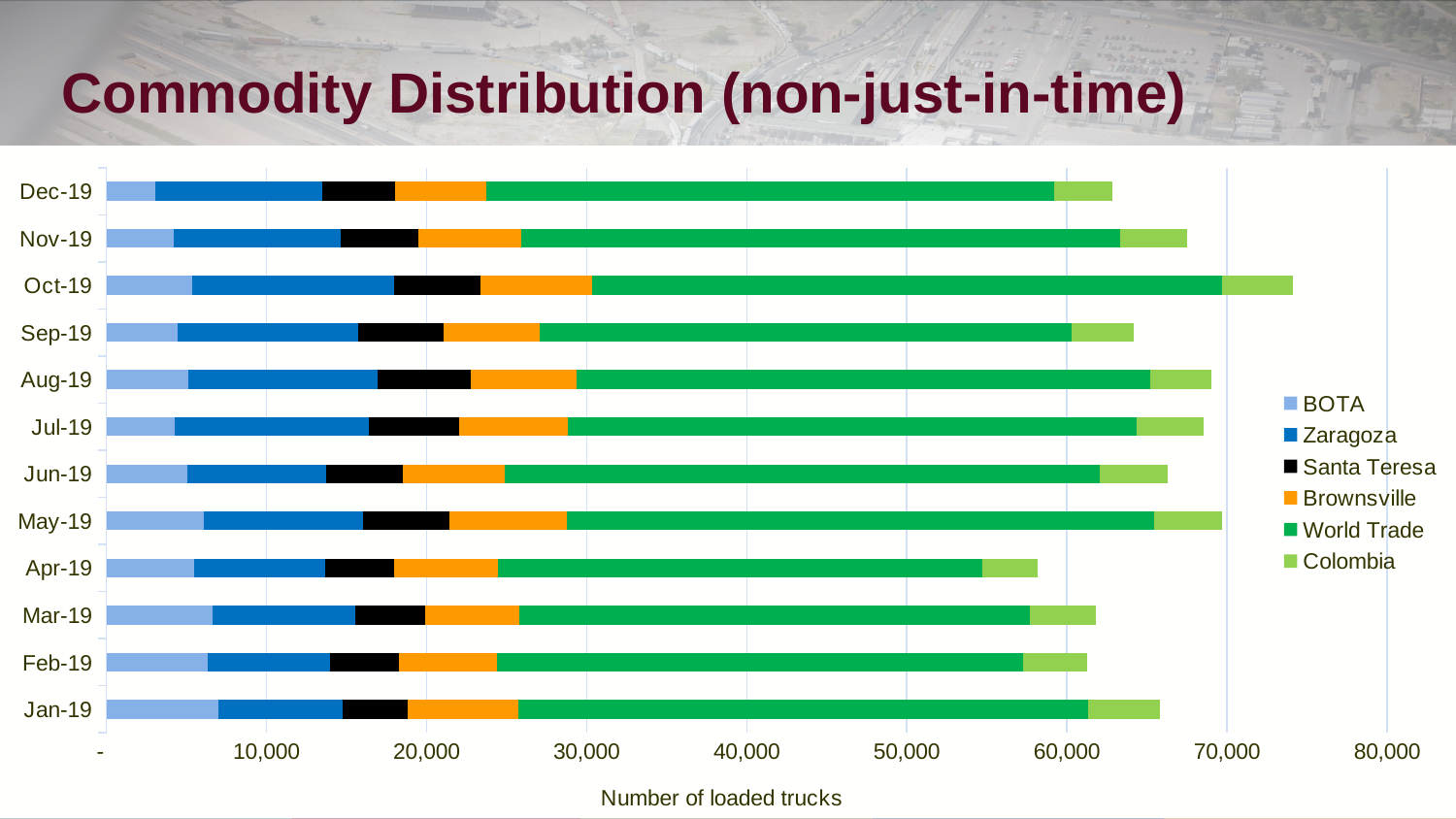
How many series does the legend list? 6 Is the total for Apr-19 greater or less than 60,000? less How many months are plotted on the chart? 12 Is the total for Oct-19 greater or less than 70,000? greater Which month has a larger total, Oct-19 or Dec-19? Oct-19 Which month has the lowest total number of loaded trucks? Apr-19 What is the title of the chart? Commodity Distribution (non-just-in-time) Is the total for Dec-19 greater or less than 70,000? less Which series accounts for the largest segment of each bar? World Trade What is the label on the horizontal axis? Number of loaded trucks Which month has the highest total number of loaded trucks? Oct-19 What kind of chart is shown on the slide? Stacked bar chart